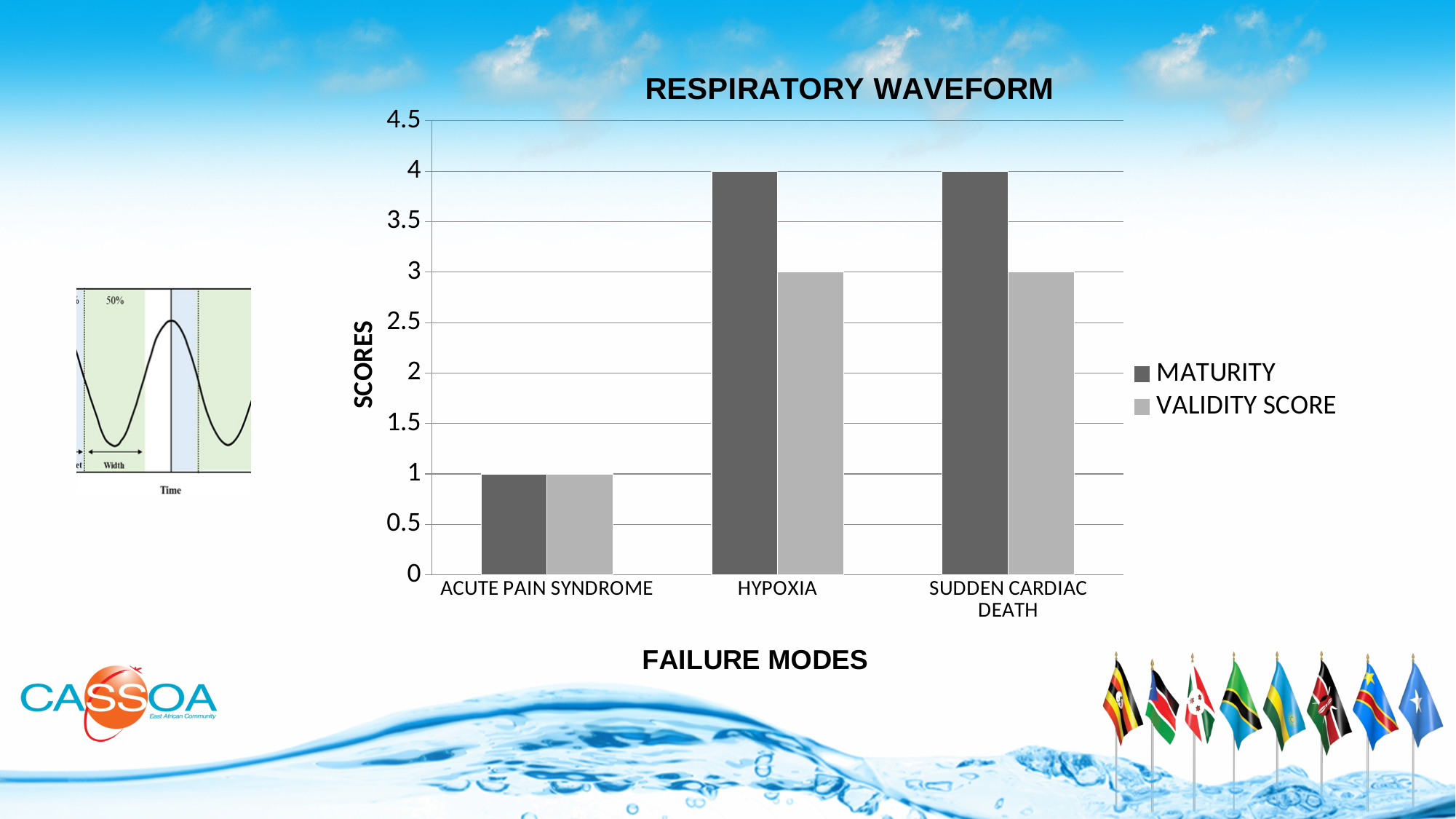
Which failure mode has the lowest Maturity score? Acute Pain Syndrome What kind of chart is shown on the slide? Bar chart What is the Maturity score for Acute Pain Syndrome? 1 What is the difference between the Maturity score and the Validity Score for Hypoxia? 1 Which is larger, the Maturity score for Hypoxia or the Validity Score for Hypoxia? Maturity score for Hypoxia What is the Maturity score for Hypoxia? 4 What is the difference between the Maturity scores for Sudden Cardiac Death and Acute Pain Syndrome? 3 How many failure modes are shown on the x axis? 3 What is the title of the chart? RESPIRATORY WAVEFORM Which failure mode has the lowest Validity Score? Acute Pain Syndrome What is the Validity Score for Sudden Cardiac Death? 3 How many series does the legend list? 2